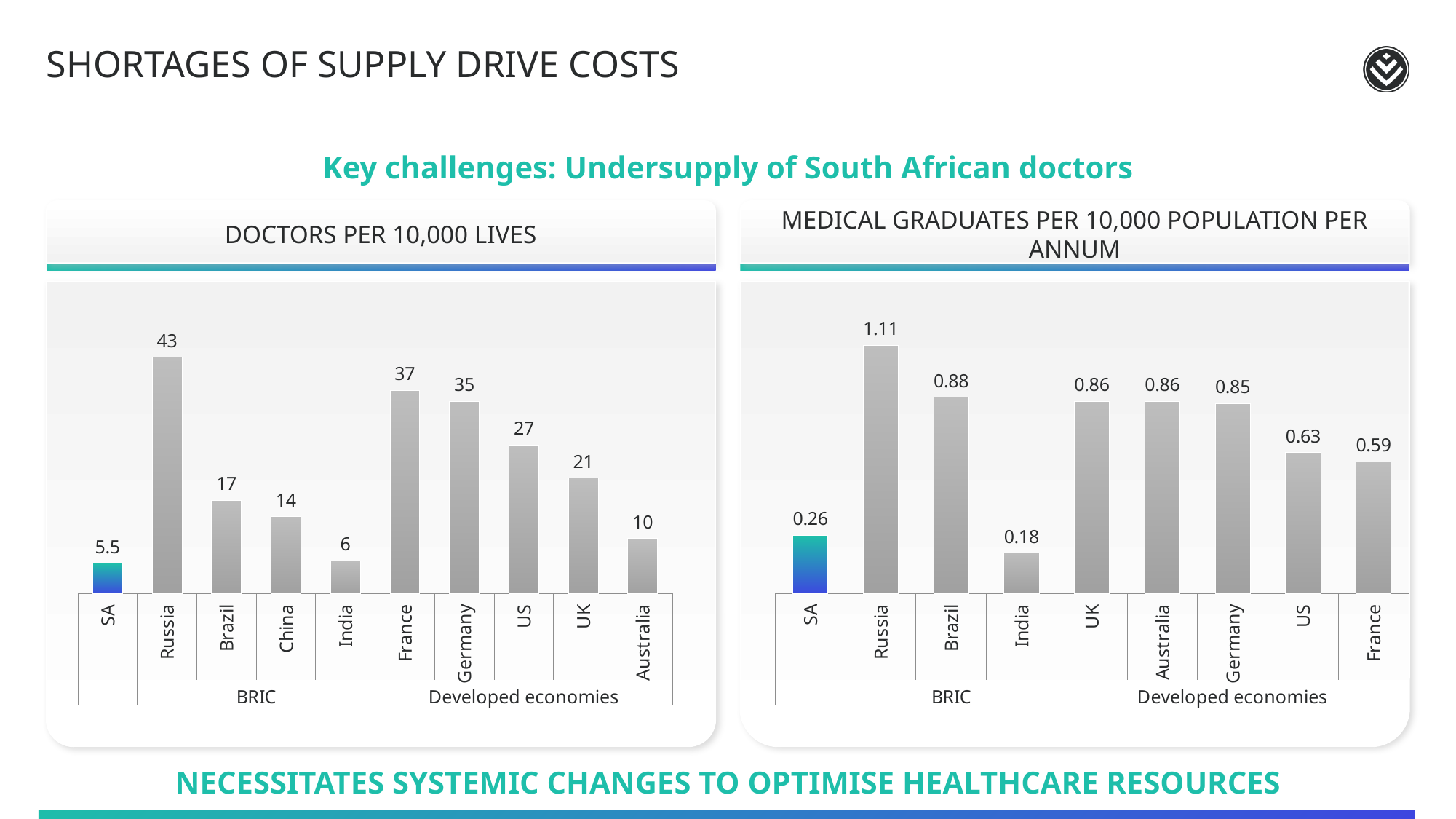
What type of chart is the 'Medical graduates per 10,000 population per annum' chart? Bar chart In the 'Medical graduates per 10,000 population per annum' chart, what is the difference between Russia and SA? 0.85 In the 'Medical graduates per 10,000 population per annum' chart, what is the value for Russia? 1.11 In the 'Doctors per 10,000 lives' chart, which is larger, the value for Brazil or the value for China? Brazil In the 'Doctors per 10,000 lives' chart, how many countries are shown? 10 In the 'Medical graduates per 10,000 population per annum' chart, which country has the lowest value? India In the 'Doctors per 10,000 lives' chart, which country has the highest value? Russia In the 'Doctors per 10,000 lives' chart, which bar is coloured differently from the others? SA In the 'Doctors per 10,000 lives' chart, what is the value for SA? 5.5 In the 'Doctors per 10,000 lives' chart, what is the difference between France and Germany? 2 In the 'Doctors per 10,000 lives' chart, which country has the lowest value? SA In the 'Medical graduates per 10,000 population per annum' chart, how many countries are shown? 9